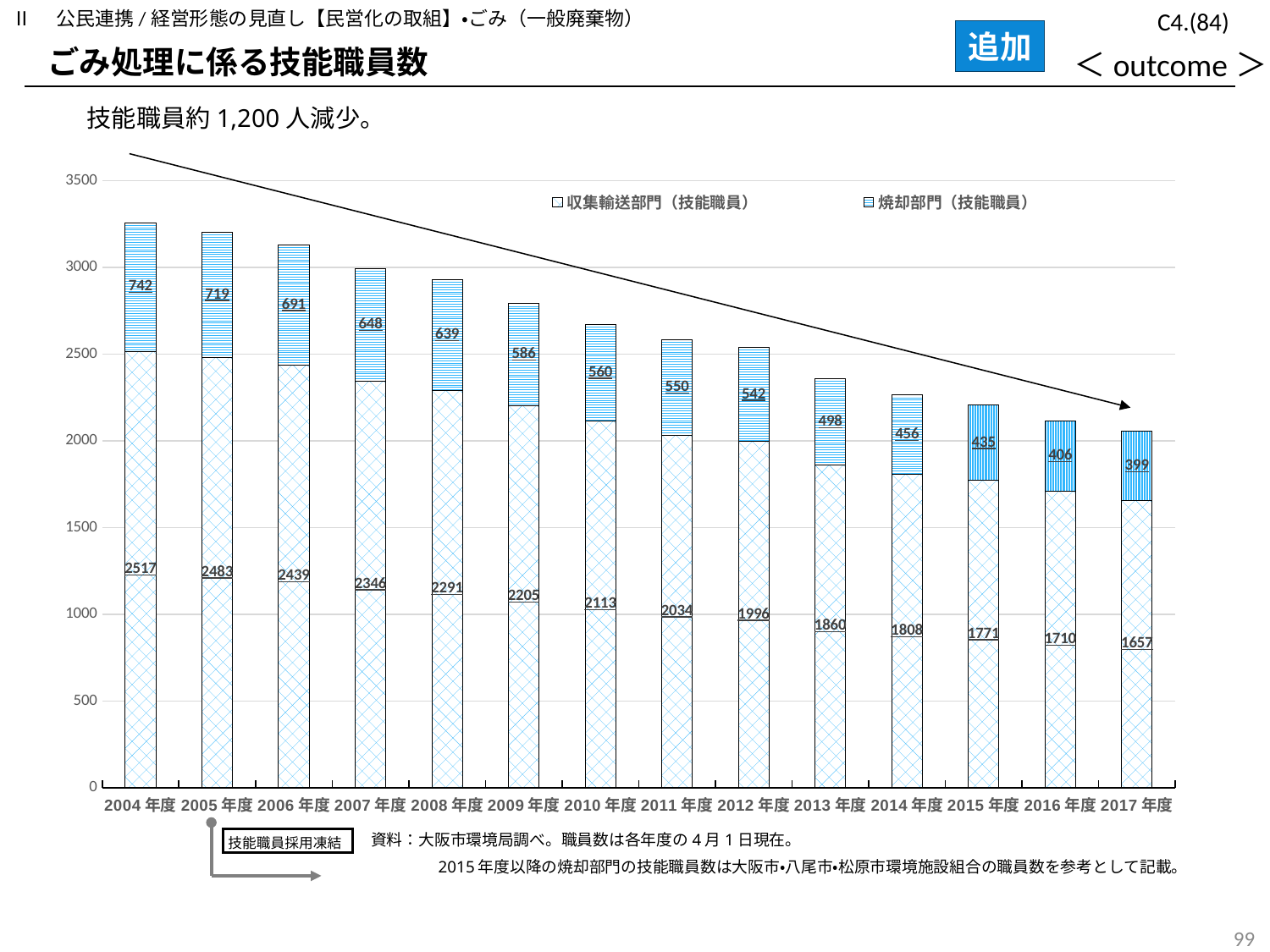
Which is larger, the 収集輸送部門（技能職員） value in 2009年度 or in 2012年度? 2009年度 What is the value for 焼却部門（技能職員） in 2017年度? 399 How many series does the legend list? 2 What is the value for 収集輸送部門（技能職員） in 2004年度? 2517 What is the value for 焼却部門（技能職員） in 2010年度? 560 What is the difference between the 収集輸送部門（技能職員） values for 2004年度 and 2017年度? 860 What type of chart is shown on the slide? bar chart How many fiscal years are shown on the x axis? 14 Which fiscal year has the lowest value for 焼却部門（技能職員）? 2017年度 Which fiscal year has the highest value for 収集輸送部門（技能職員）? 2004年度 What is the total of the stacked bar for 2017年度? 2056 Do the 焼却部門（技能職員） values rise or fall from 2004年度 to 2017年度? fall